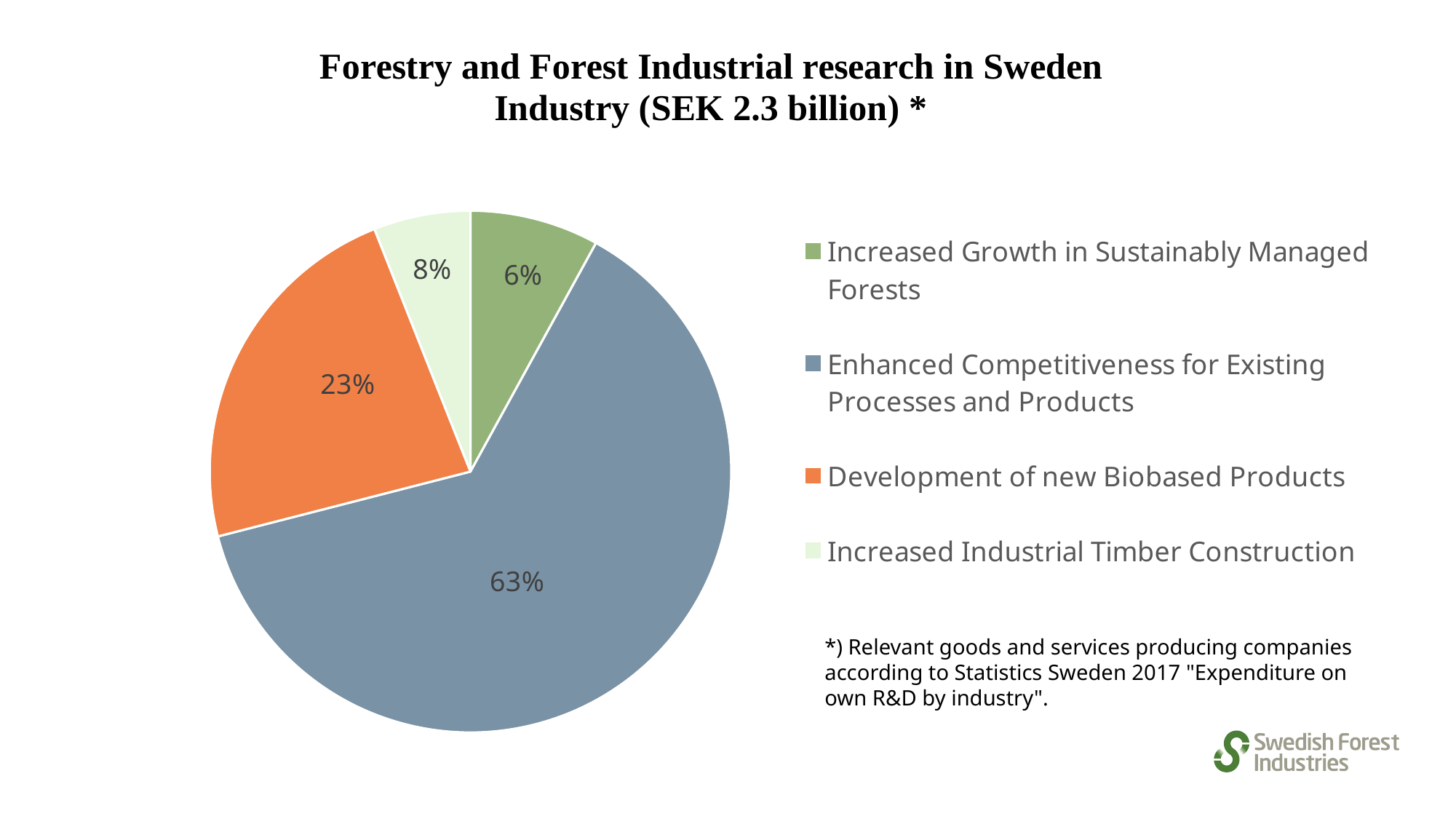
How many categories does the pie chart have? 4 Which is larger: the share for Increased Industrial Timber Construction or the share for Increased Growth in Sustainably Managed Forests? Increased Industrial Timber Construction What share of the pie does Enhanced Competitiveness for Existing Processes and Products have? 63% What is the title of the chart? Forestry and Forest Industrial research in Sweden Industry (SEK 2.3 billion) * What is the difference in percentage points between Enhanced Competitiveness for Existing Processes and Products and Development of new Biobased Products? 40 percentage points What share of the pie does Development of new Biobased Products have? 23% Which category has the smallest slice of the pie? Increased Growth in Sustainably Managed Forests What share of the pie does Increased Growth in Sustainably Managed Forests have? 6% Which category has the largest slice of the pie? Enhanced Competitiveness for Existing Processes and Products Which category is shown in orange in the pie chart? Development of new Biobased Products What kind of chart is shown on the slide? Pie chart